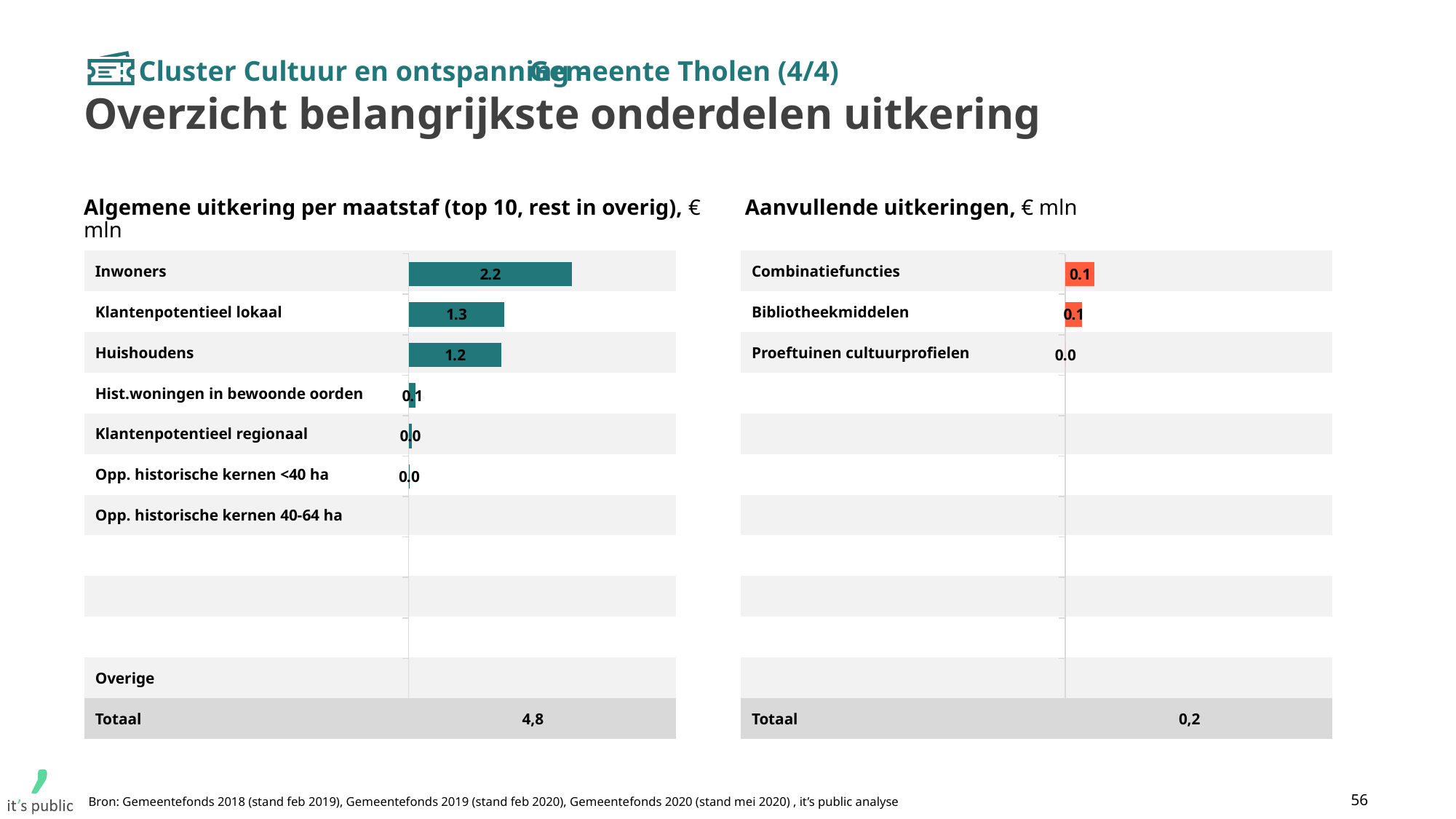
In the 'Algemene uitkering per maatstaf' chart, what is the value for Hist.woningen in bewoonde oorden? 0.1 In the 'Algemene uitkering per maatstaf' chart, what is the value for Klantenpotentieel lokaal? 1.3 In the 'Aanvullende uitkeringen' chart, what is the value for Combinatiefuncties? 0.1 How many categories are shown in the 'Aanvullende uitkeringen' chart? 3 What is the Totaal shown in the 'Algemene uitkering per maatstaf' chart? 4,8 In the 'Algemene uitkering per maatstaf' chart, what is the value for Inwoners? 2.2 In the 'Aanvullende uitkeringen' chart, what is the value for Proeftuinen cultuurprofielen? 0.0 In the 'Algemene uitkering per maatstaf' chart, what is the value for Huishoudens? 1.2 In the 'Algemene uitkering per maatstaf' chart, which is larger: Klantenpotentieel lokaal or Huishoudens? Klantenpotentieel lokaal In the 'Algemene uitkering per maatstaf' chart, which category has the highest value? Inwoners In the 'Algemene uitkering per maatstaf' chart, what is the difference between Inwoners and Huishoudens? 1.0 What type of chart is the 'Aanvullende uitkeringen' chart? Bar chart